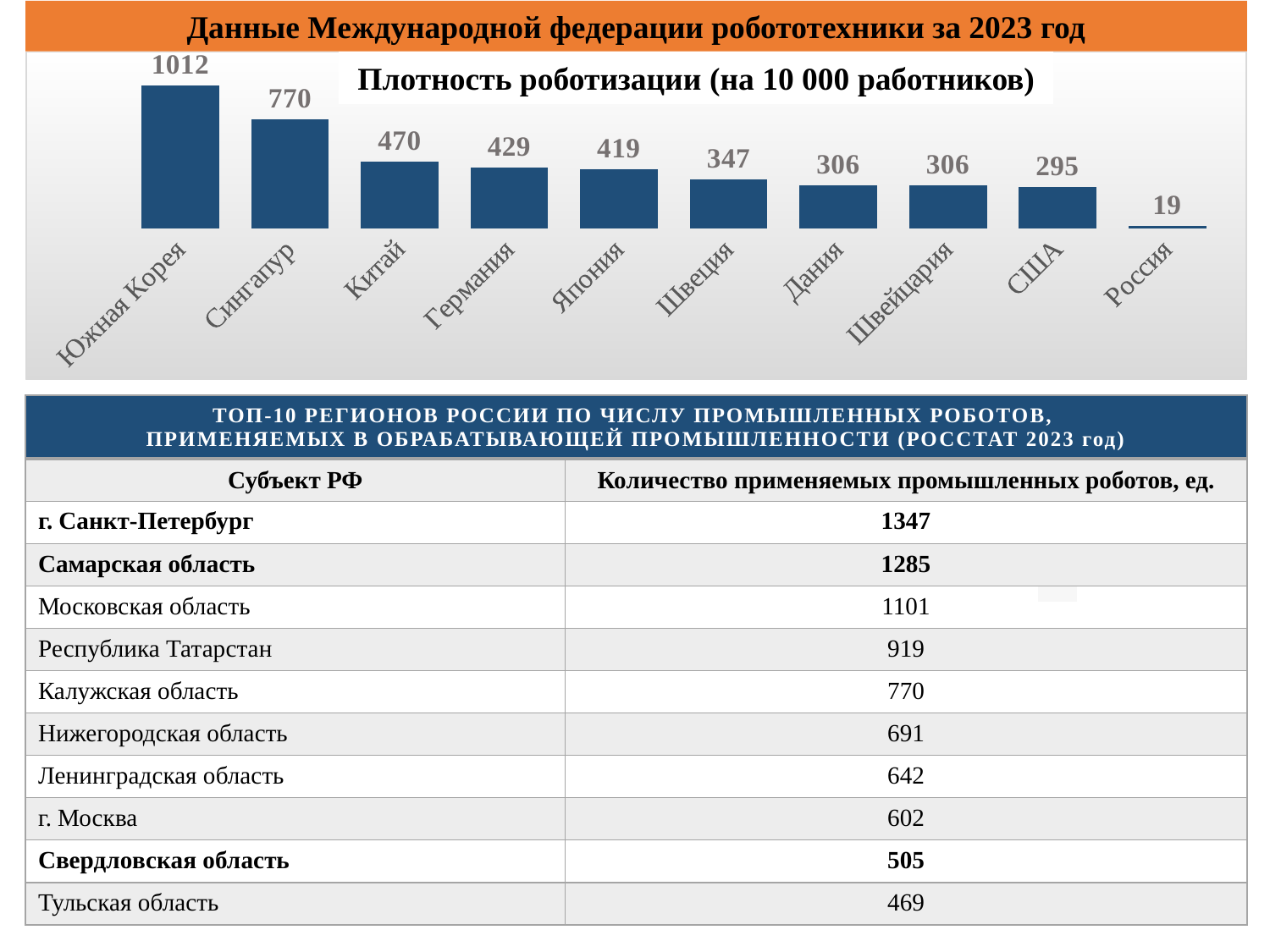
What type of chart is used to show robot density on the slide? Bar chart What is the value for Россия in the bar chart? 19 What is the difference between the values for Южная Корея and Сингапур in the bar chart? 242 Which country has the highest bar in the chart? Южная Корея What is the robot density value shown for Южная Корея in the bar chart? 1012 What value is labelled on the bar for Швеция? 347 What value does the bar chart show for Германия? 429 What is the difference between the values for Китай and США in the bar chart? 175 Which country has the lowest value in the bar chart? Россия What is the title of the bar chart on the slide? Плотность роботизации (на 10 000 работников) How many countries are shown in the bar chart? 10 Which has a larger value in the bar chart, Япония or Швеция? Япония